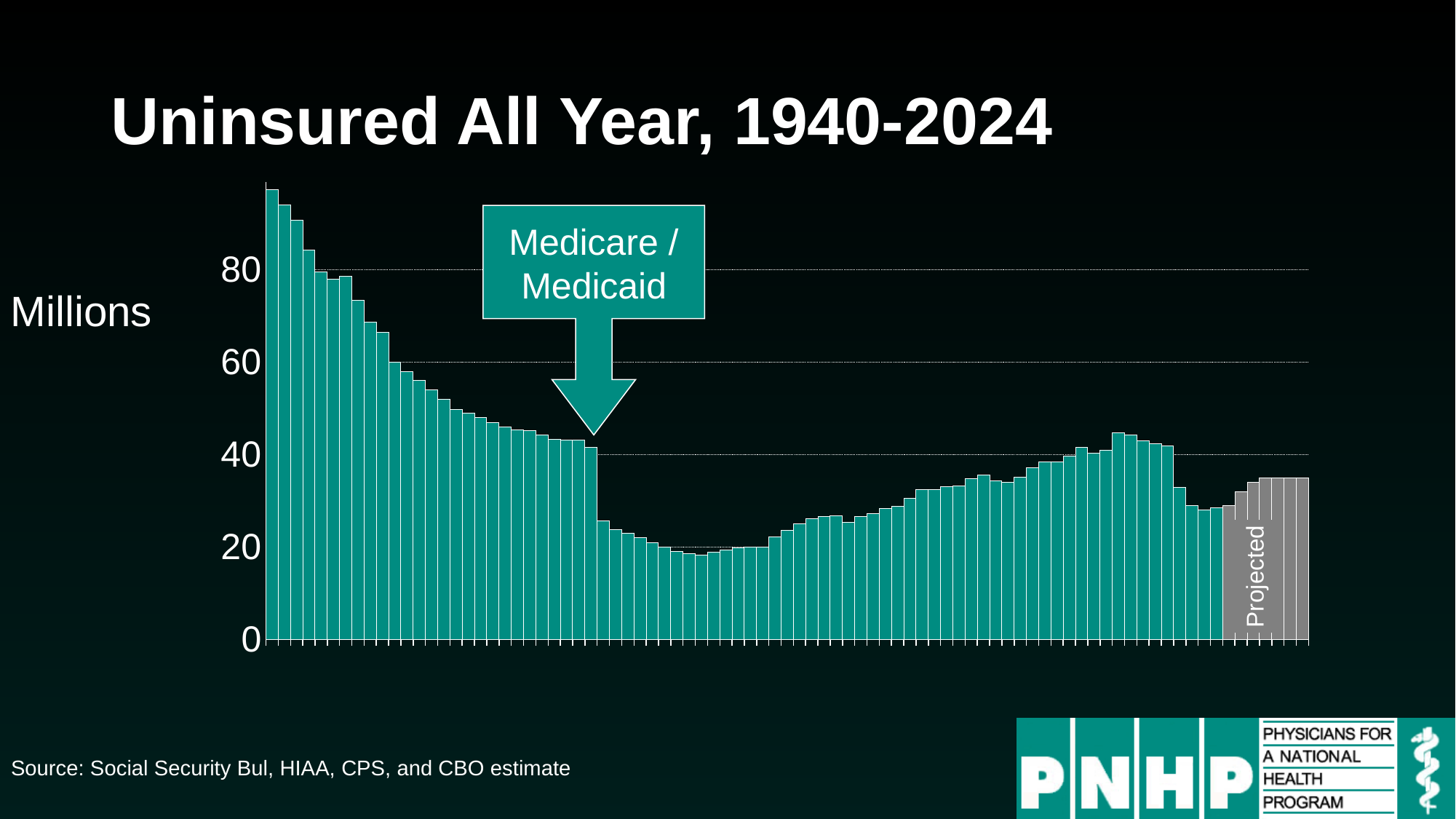
Is the value of the bar just before the Medicare / Medicaid arrow greater or less than 40? greater Which is larger, the leftmost bar or the rightmost bar? the leftmost bar What event does the arrow annotation on the chart mark? Medicare / Medicaid From the leftmost bar up to the Medicare / Medicaid arrow, do the values rise or fall? fall Is the value of the rightmost (projected) bar greater or less than 40? less Is the value of the rightmost (projected) bar greater or less than 20? greater What kind of chart is shown on the slide? bar chart Which bar has the highest value in the chart? the leftmost bar What is the title of the chart? Uninsured All Year, 1940-2024